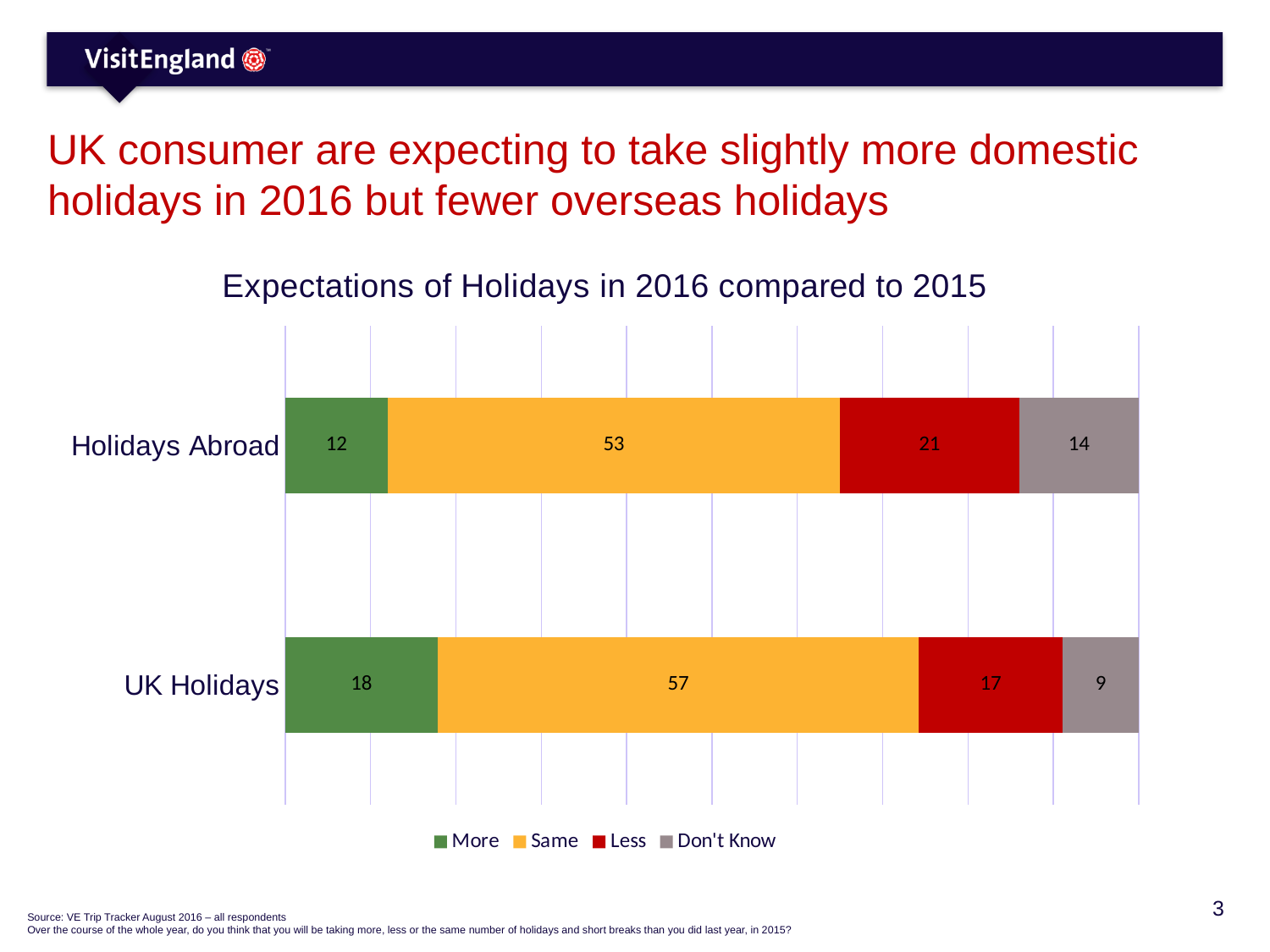
Which category has the higher "Less" value, Holidays Abroad or UK Holidays? Holidays Abroad What is the value for "Same" for Holidays Abroad? 53 What is the difference between the "Same" values for UK Holidays and Holidays Abroad? 4 How many categories are shown on the chart? 2 How many series does the legend list? 4 What is the value for "Less" for UK Holidays? 17 What is the value for "Don't Know" for Holidays Abroad? 14 What is the total of the stacked bar for UK Holidays? 101 What type of chart is shown? Stacked bar chart What is the value for "More" for UK Holidays? 18 What is the total of the stacked bar for Holidays Abroad? 100 What is the difference between the "More" values for UK Holidays and Holidays Abroad? 6